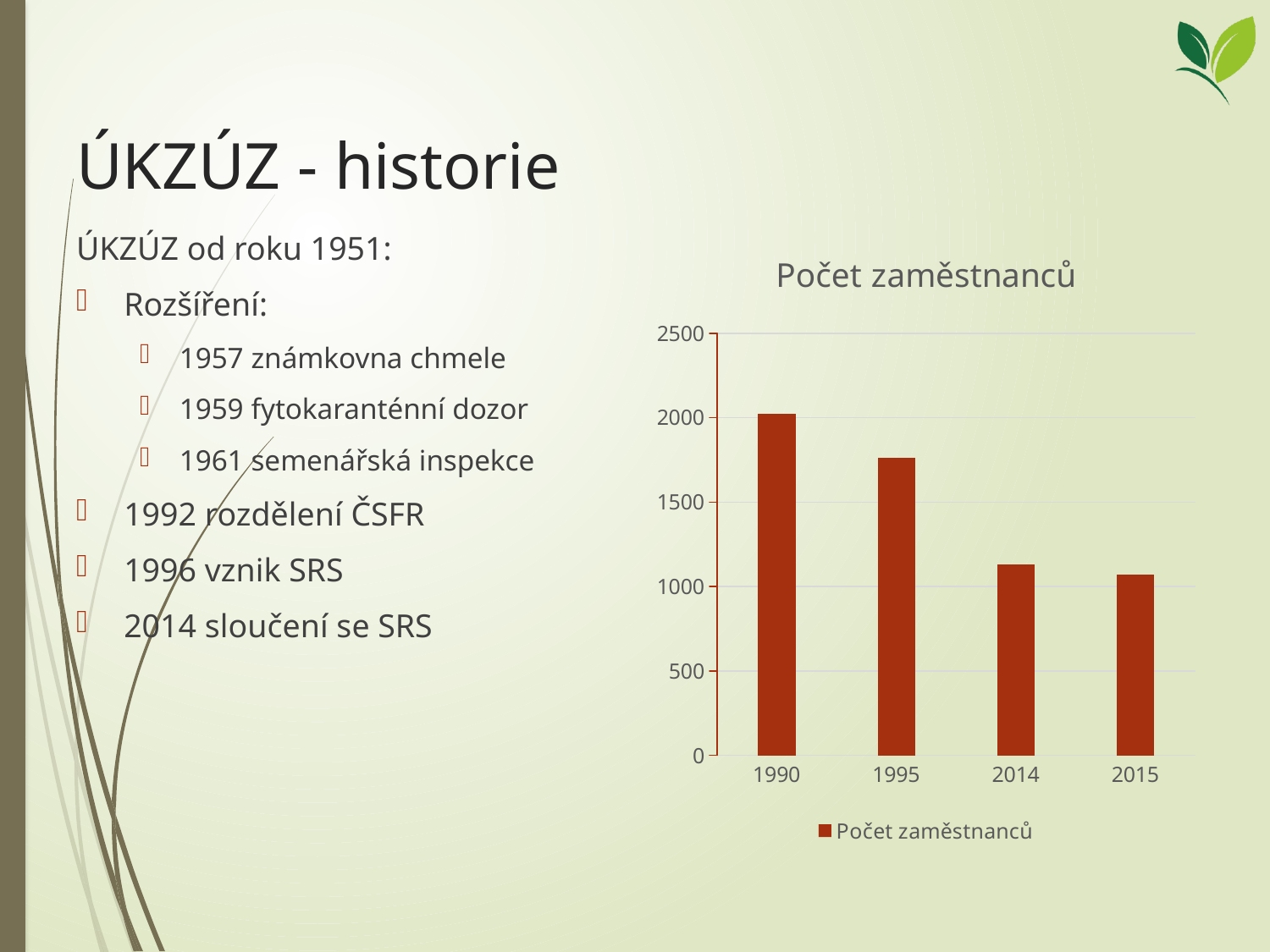
Is the value for 1990 greater or less than 1500? greater What is the title of the chart? Počet zaměstnanců How many categories (years) are shown on the x axis of the chart? 4 Which year has the highest number of employees in the chart? 1990 Which is larger, the value for 1995 or the value for 2014? 1995 Is the value for 1995 greater or less than 1500? greater What is the name of the series shown in the chart legend? Počet zaměstnanců How many series does the chart legend list? 1 Is the value for 2015 greater or less than 1500? less Do the values rise or fall from 1990 to 2015 along the x axis? fall What type of chart is shown on the slide? bar chart